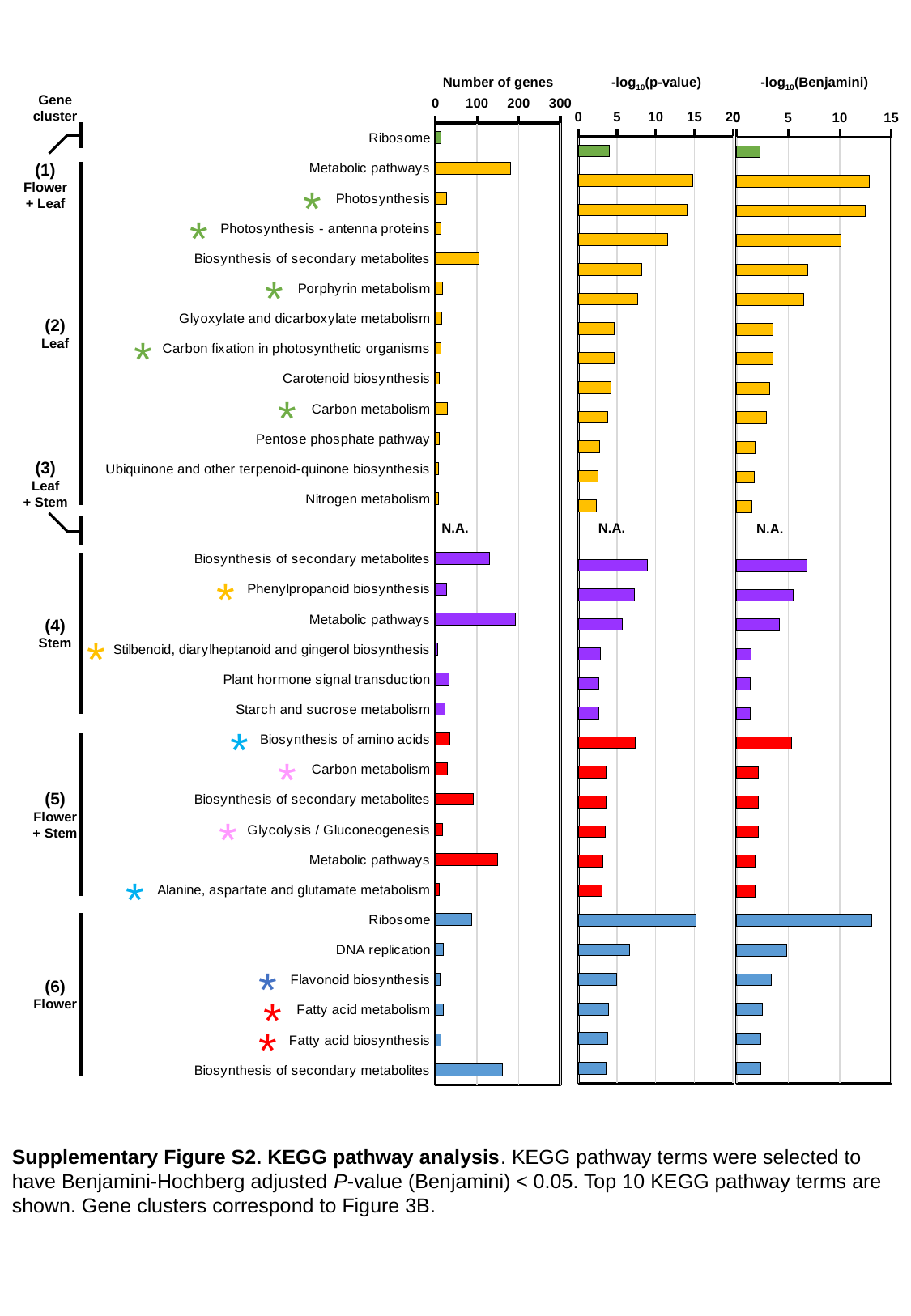
In the '-log10(Benjamini)' chart, is the value for Ribosome in cluster (6) Flower greater or less than 10? greater In the 'Number of genes' chart, which has more genes in cluster (2) Leaf: Metabolic pathways or Photosynthesis? Metabolic pathways In the 'Number of genes' chart, is the value for Photosynthesis in cluster (2) Leaf greater or less than 100? less What colour are the bars for cluster (6) Flower? blue How many chart panels are shown side by side on the slide? 3 In the 'Number of genes' chart, is the value for Biosynthesis of secondary metabolites in cluster (6) Flower greater or less than 100? greater What kind of chart is used in the 'Number of genes' panel? bar chart How many KEGG pathway terms are listed for cluster (6) Flower? 6 In the '-log10(p-value)' chart, which is larger in cluster (5) Flower + Stem: Biosynthesis of amino acids or Carbon metabolism? Biosynthesis of amino acids